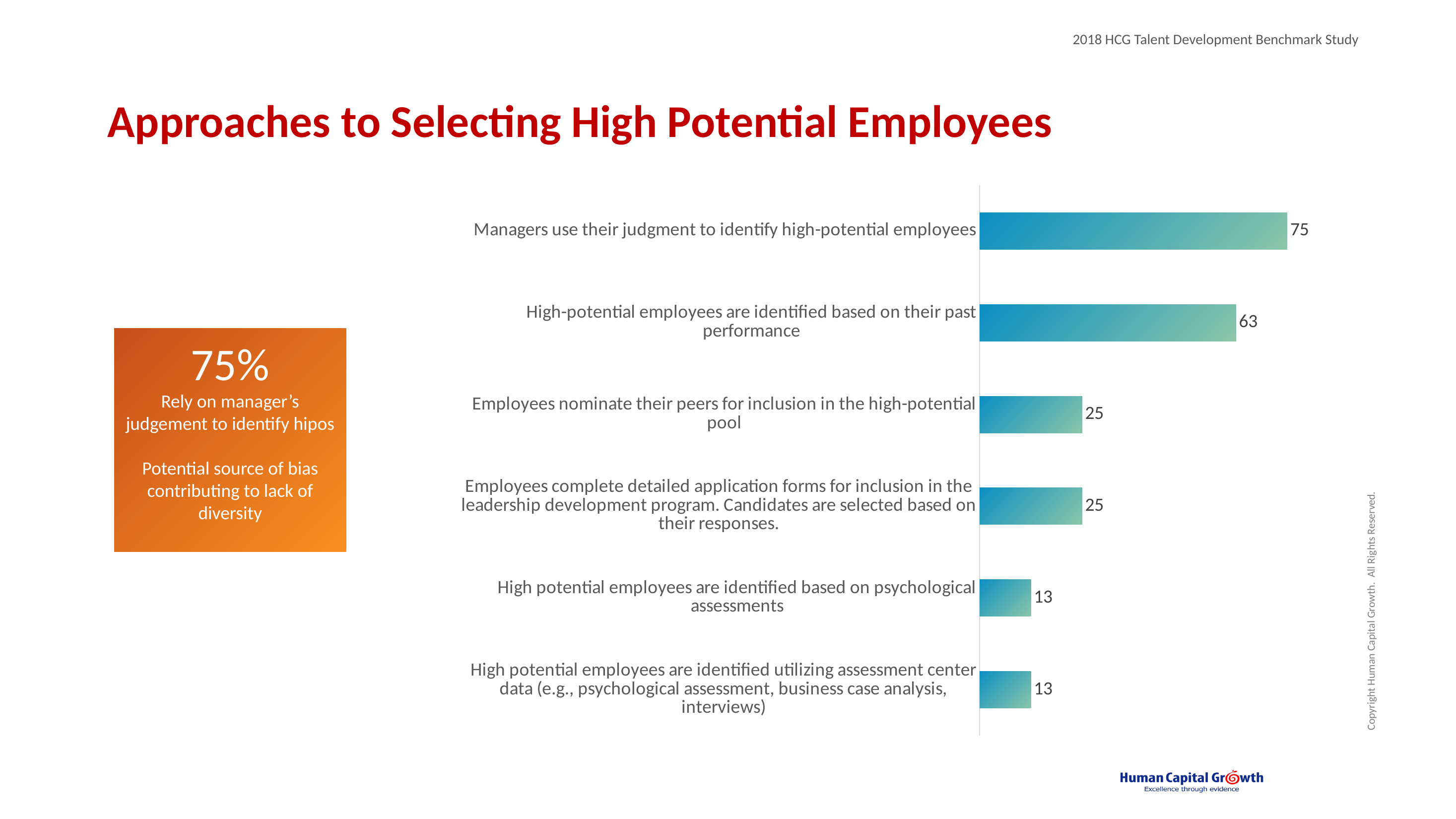
What is the difference between the values for "Employees nominate their peers for inclusion in the high-potential pool" and "High potential employees are identified based on psychological assessments"? 12 What is the value for "High-potential employees are identified based on their past performance"? 63 What percentage is highlighted in the orange box to the left of the chart? 75% Which is larger: the value for "High-potential employees are identified based on their past performance" or the value for "Employees nominate their peers for inclusion in the high-potential pool"? High-potential employees are identified based on their past performance What is the title of the slide containing the chart? Approaches to Selecting High Potential Employees What is the difference between the values for "Managers use their judgment to identify high-potential employees" and "High-potential employees are identified based on their past performance"? 12 How many categories are shown in the chart? 6 What is the value for "High potential employees are identified based on psychological assessments"? 13 What kind of chart is shown on the slide? Bar chart What is the value for "Managers use their judgment to identify high-potential employees"? 75 What is the value for "Employees nominate their peers for inclusion in the high-potential pool"? 25 Which category has the highest value? Managers use their judgment to identify high-potential employees